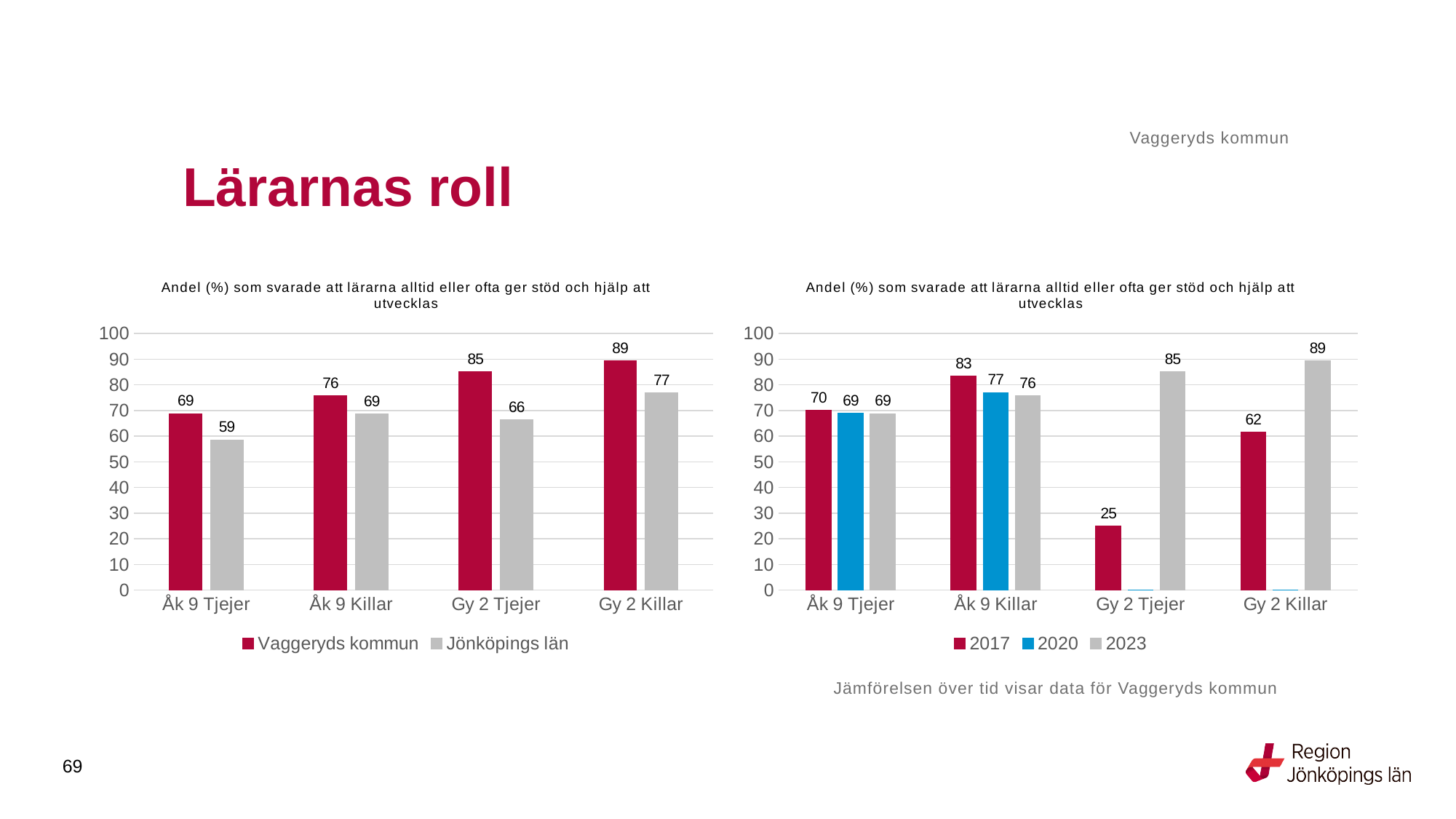
In the left chart, what is the value for Jönköpings län for Åk 9 Tjejer? 59 In the left chart, what is the difference between Vaggeryds kommun and Jönköpings län for Gy 2 Tjejer? 19 In the right chart, how many series does the legend list? 3 In the right chart, what is the difference between the 2023 and 2017 values for Gy 2 Tjejer? 60 In the right chart, which is larger for Gy 2 Killar: the 2017 value or the 2023 value? 2023 In the left chart, what is the value for Vaggeryds kommun for Gy 2 Killar? 89 In the right chart, which category has the highest value for 2023? Gy 2 Killar In the right chart, what is the value for 2017 for Gy 2 Tjejer? 25 What type of chart is the left chart? Bar chart In the left chart, how many series does the legend list? 2 In the right chart, what is the value for 2020 for Åk 9 Killar? 77 In the left chart, which category has the lowest value for Jönköpings län? Åk 9 Tjejer